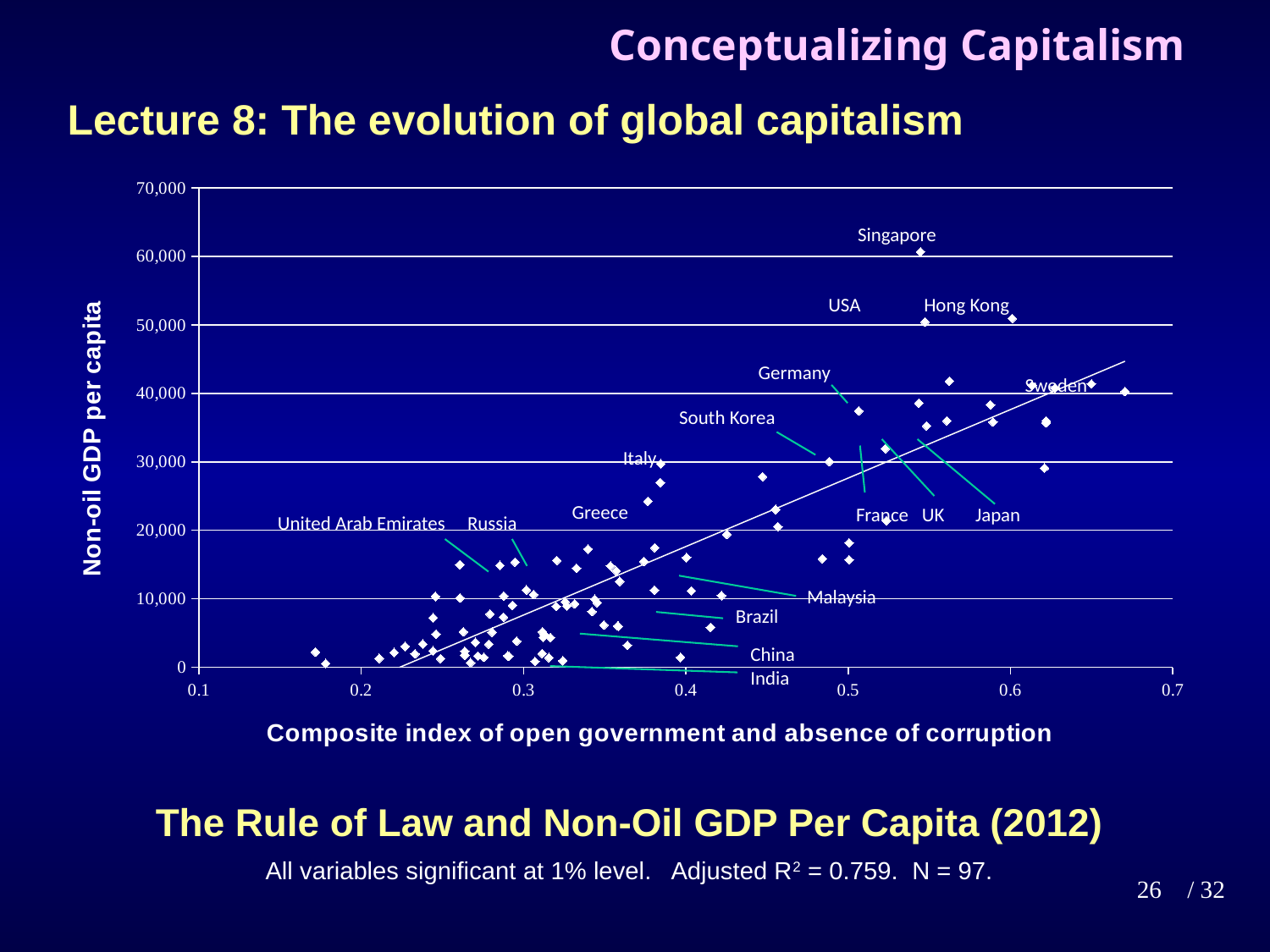
What kind of chart is shown on the slide? Scatter plot What is the label of the x axis? Composite index of open government and absence of corruption Is the value for Singapore greater or less than 50,000? greater Which labelled country has the highest non-oil GDP per capita? Singapore Is the value for Hong Kong greater or less than 40,000? greater Do the values generally rise or fall as the composite index increases along the x axis? rise Which has the higher non-oil GDP per capita, Greece or India? Greece Is the value for Japan greater or less than 30,000? greater How many observations (N) does the chart caption state? 97 Which has the higher non-oil GDP per capita, Singapore or USA? Singapore